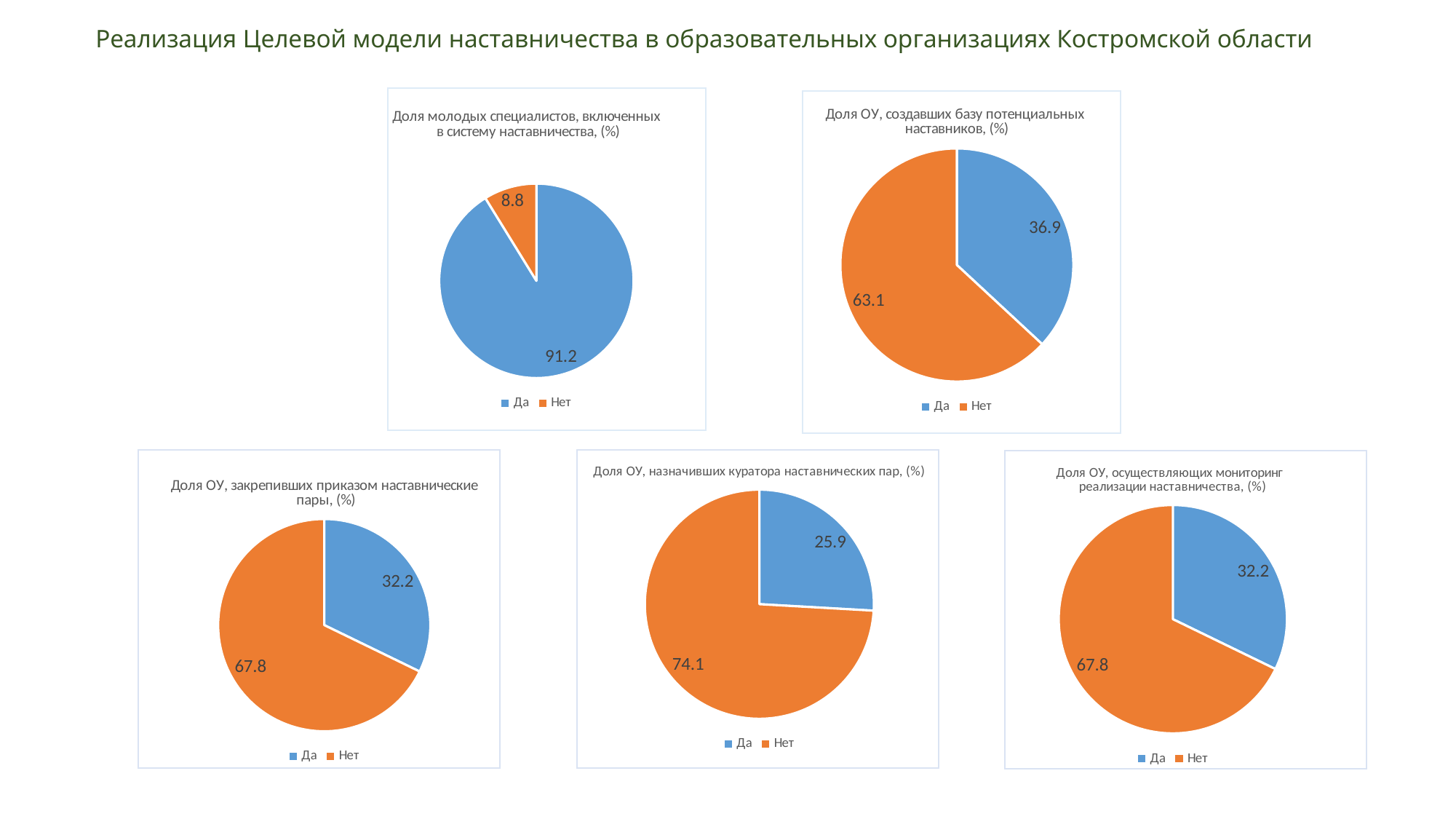
In the chart titled "Доля ОУ, осуществляющих мониторинг реализации наставничества, (%)", which slice is the largest? Нет How many slices does the chart titled "Доля ОУ, закрепивших приказом наставнические пары, (%)" have? 2 In the chart titled "Доля ОУ, создавших базу потенциальных наставников, (%)", what is the value for "Да"? 36.9 In the chart titled "Доля ОУ, создавших базу потенциальных наставников, (%)", which slice is larger, "Да" or "Нет"? Нет In the chart titled "Доля ОУ, осуществляющих мониторинг реализации наставничества, (%)", what is the value for "Да"? 32.2 What type of chart is the chart titled "Доля молодых специалистов, включенных в систему наставничества, (%)"? Pie chart In the chart titled "Доля молодых специалистов, включенных в систему наставничества, (%)", what is the value for "Нет"? 8.8 In the chart titled "Доля ОУ, закрепивших приказом наставнические пары, (%)", what is the value for "Нет"? 67.8 In the chart titled "Доля ОУ, назначивших куратора наставнических пар, (%)", what is the difference between the "Нет" and "Да" values? 48.2 In the chart titled "Доля молодых специалистов, включенных в систему наставничества, (%)", what is the value for "Да"? 91.2 In the chart titled "Доля ОУ, создавших базу потенциальных наставников, (%)", what colour is the "Нет" slice? Orange In the chart titled "Доля ОУ, назначивших куратора наставнических пар, (%)", what is the value for "Да"? 25.9